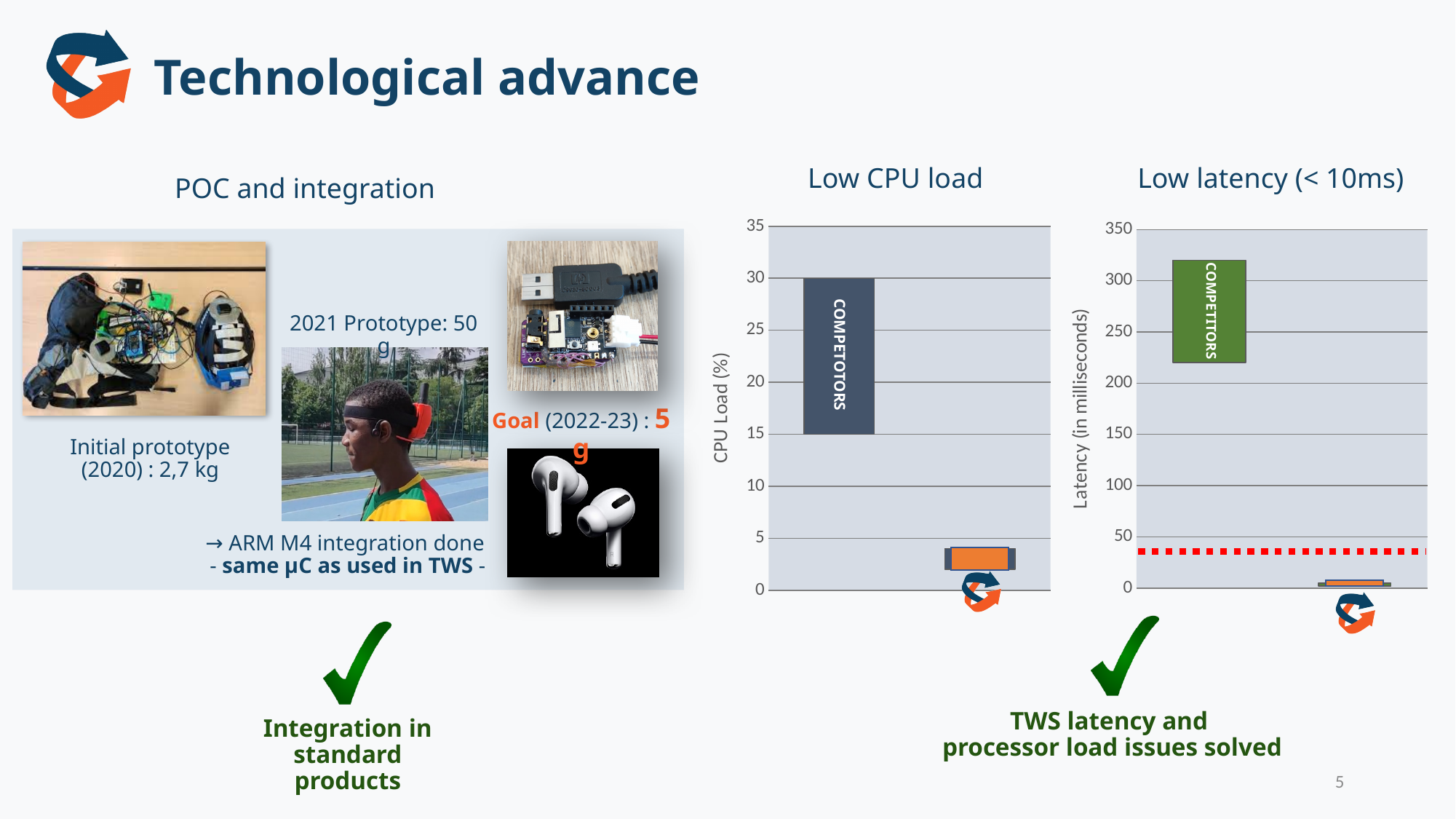
On the Low latency (< 10ms) chart, what is the maximum value shown on the y-axis? 350 On the Low CPU load chart, which bar is higher, COMPETITORS or the company's bar marked with the logo? COMPETITORS On the Low CPU load chart, is the value for the company's bar (marked with the logo) greater or less than 5? less On the Low latency (< 10ms) chart, is the bottom of the COMPETITORS bar greater or less than 200? greater On the Low latency (< 10ms) chart, is the value for the company's bar (marked with the logo) greater or less than 50? less On the Low CPU load chart, what kind of chart is shown? bar chart On the Low CPU load chart, what is the top value of the COMPETITORS bar? 30 On the Low CPU load chart, what is the y-axis label? CPU Load (%) On the Low latency (< 10ms) chart, what is the y-axis label? Latency (in milliseconds) On the Low CPU load chart, what is the bottom value of the COMPETITORS bar? 15